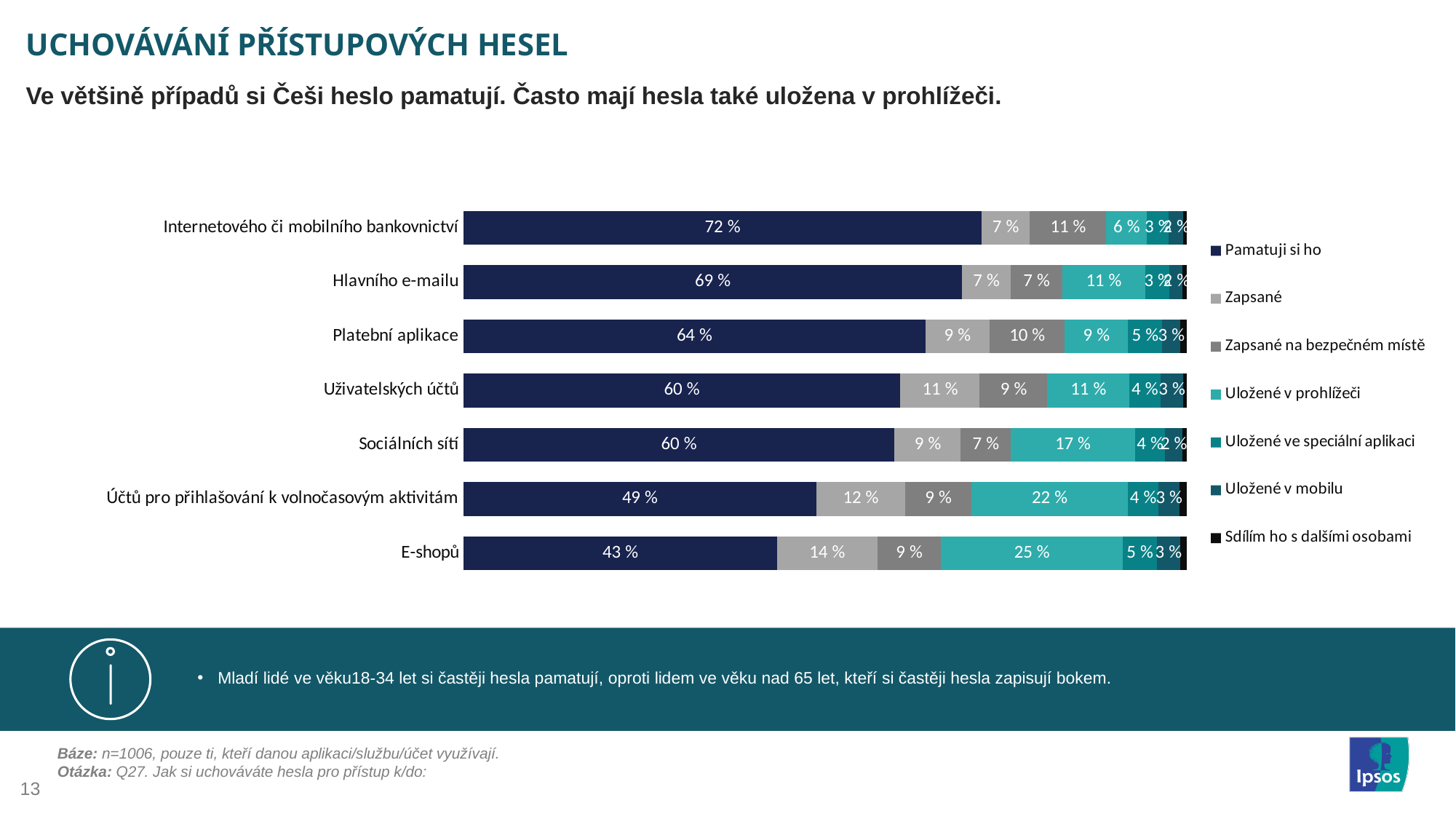
What is the "Zapsané" value for Účtů pro přihlašování k volnočasovým aktivitám? 12 % Which category has the highest "Pamatuji si ho" value? Internetového či mobilního bankovnictví What type of chart is shown on the slide? Stacked bar chart What percentage of respondents say they remember ("Pamatuji si ho") their password for E-shopů? 43 % How many categories (account types) are shown in the chart? 7 Which category has the lowest "Pamatuji si ho" value? E-shopů Which category has the highest "Uložené v prohlížeči" value? E-shopů What is the "Pamatuji si ho" value for Platební aplikace? 64 % Which has a larger "Uložené v prohlížeči" value: Hlavního e-mailu or Platební aplikace? Hlavního e-mailu What is the "Uložené v prohlížeči" value for Sociálních sítí? 17 % How many series does the legend list? 7 What is the difference between the "Pamatuji si ho" values for Internetového či mobilního bankovnictví and E-shopů? 29 percentage points